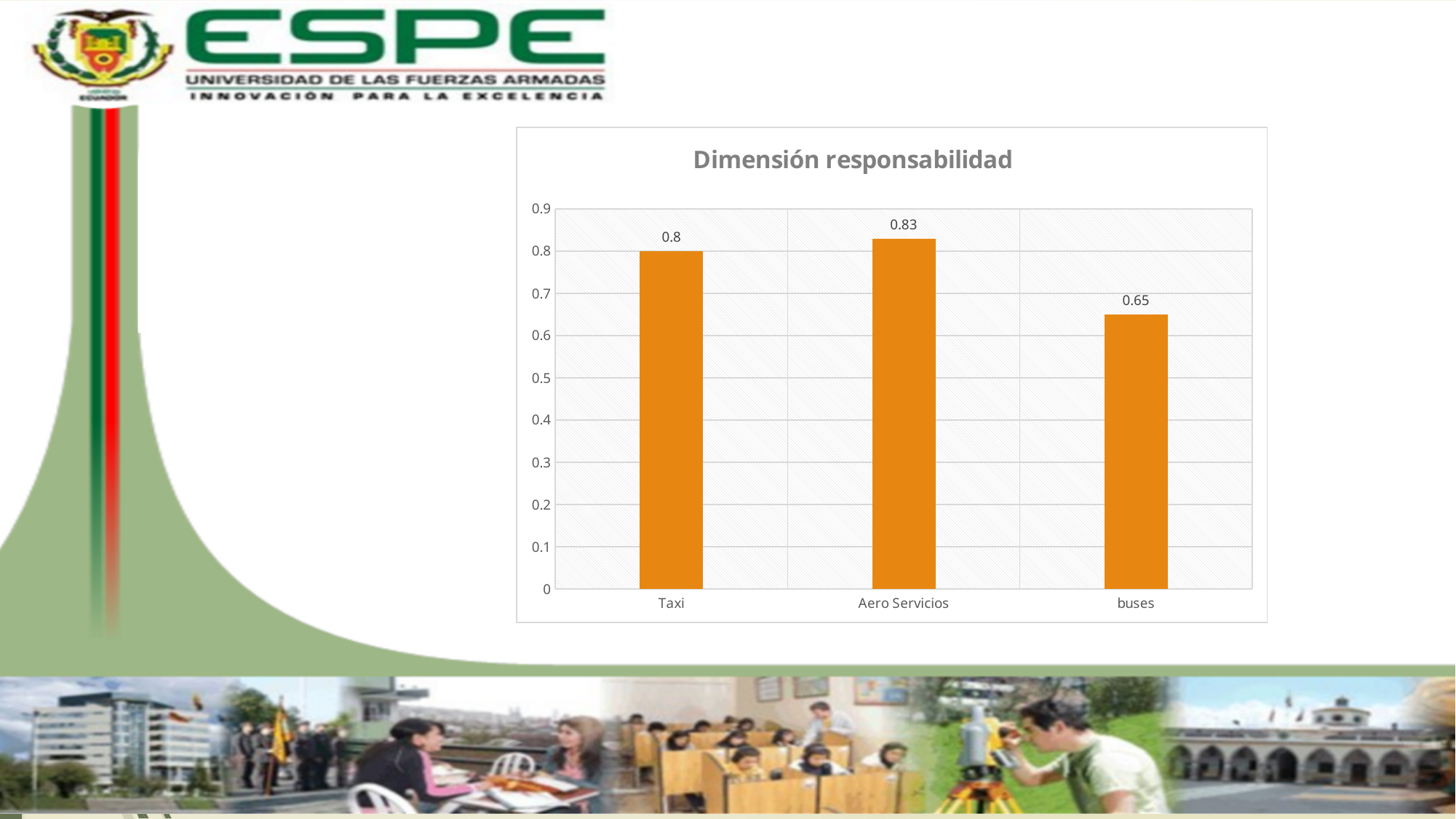
What is the difference between the values for Aero Servicios and buses? 0.18 What is the value for buses? 0.65 What is the value for Taxi? 0.8 Which category has the lowest value? buses What kind of chart is shown? bar chart Which is larger, the value for Taxi or the value for buses? Taxi What is the value for Aero Servicios? 0.83 Which category has the highest value? Aero Servicios Is the value for buses greater or less than 0.7? less What is the difference between the values for Taxi and buses? 0.15 How many categories are shown on the x axis? 3 What is the title of the chart? Dimensión responsabilidad